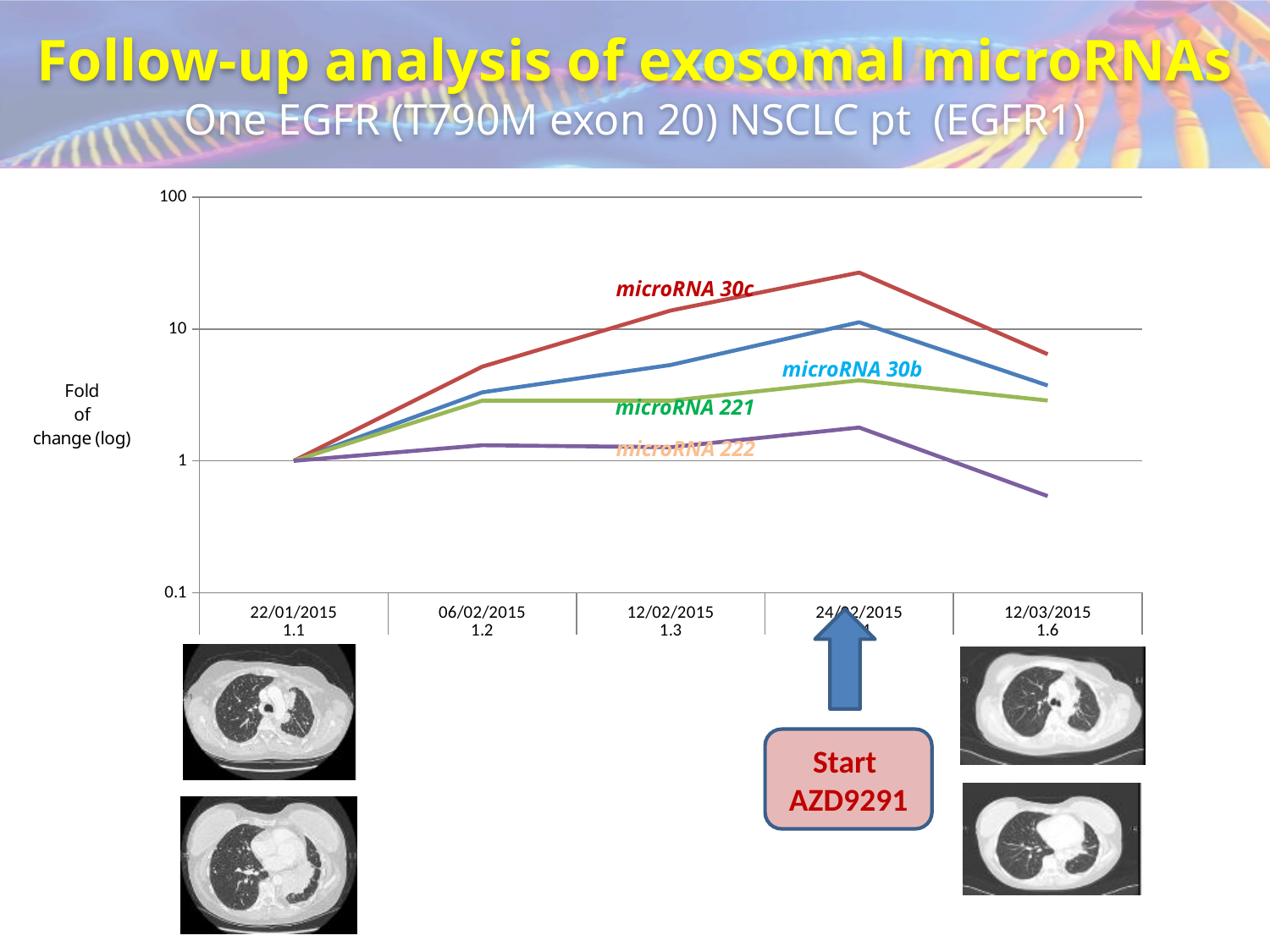
What is the label on the y axis of the chart? Fold of change (log) Is the value for microRNA 222 at 12/03/2015 greater or less than 1? less Is the value for microRNA 221 at 24/02/2015 greater or less than 10? less Which microRNA has the lowest fold of change at 12/03/2015? microRNA 222 At 12/02/2015, which is higher: microRNA 30c or microRNA 30b? microRNA 30c Does the value for microRNA 30c rise or fall between 24/02/2015 and 12/03/2015? fall How many dates are shown along the x axis of the chart? 5 How many microRNA series are plotted on the chart? 4 Which microRNA has the highest fold of change at 24/02/2015? microRNA 30c Is the value for microRNA 30c at 24/02/2015 greater or less than 10? greater What kind of chart is shown on the slide? line chart What is the fold of change for microRNA 30c at 22/01/2015? 1